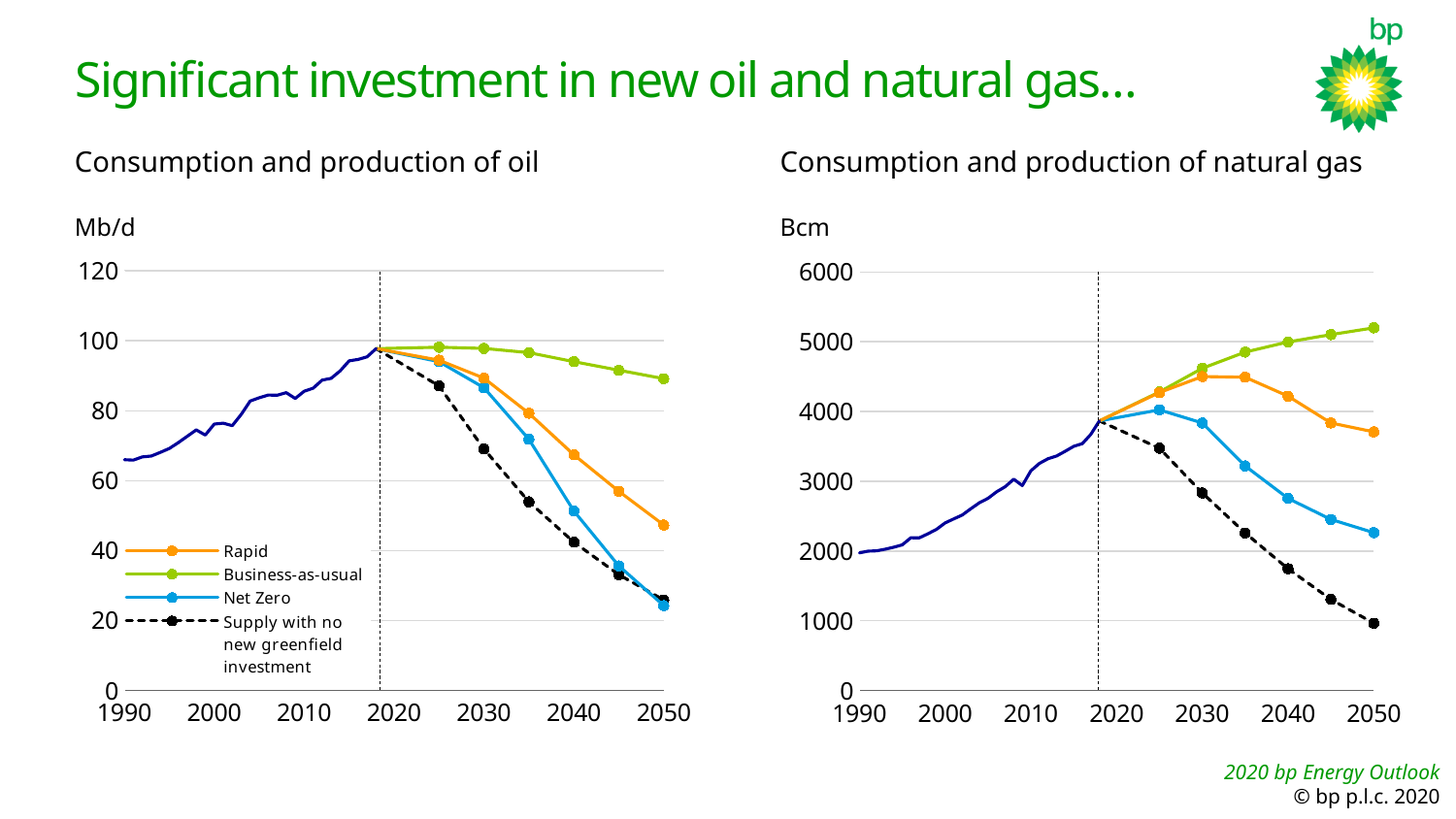
On the 'Consumption and production of natural gas' chart, which is larger in 2050: the Rapid (orange) value or the Net Zero (blue) value? Rapid On the 'Consumption and production of natural gas' chart, is the black dashed 'Supply with no new greenfield investment' value in 2050 greater or less than 2000? less What unit is shown on the y axis of the 'Consumption and production of natural gas' chart? Bcm On the 'Consumption and production of natural gas' chart, does the Business-as-usual (green) line rise or fall between 2020 and 2050? rise On the 'Consumption and production of oil' chart, is the Business-as-usual value in 2050 greater or less than 80? greater How many series does the legend on the 'Consumption and production of oil' chart list? 4 On the 'Consumption and production of oil' chart, does the Rapid line rise or fall between 2020 and 2050? fall On the 'Consumption and production of natural gas' chart, is the Net Zero (blue) value in 2050 greater or less than 3000? less What kind of chart is the 'Consumption and production of oil' chart? line chart On the 'Consumption and production of oil' chart, which scenario has the highest value in 2050? Business-as-usual